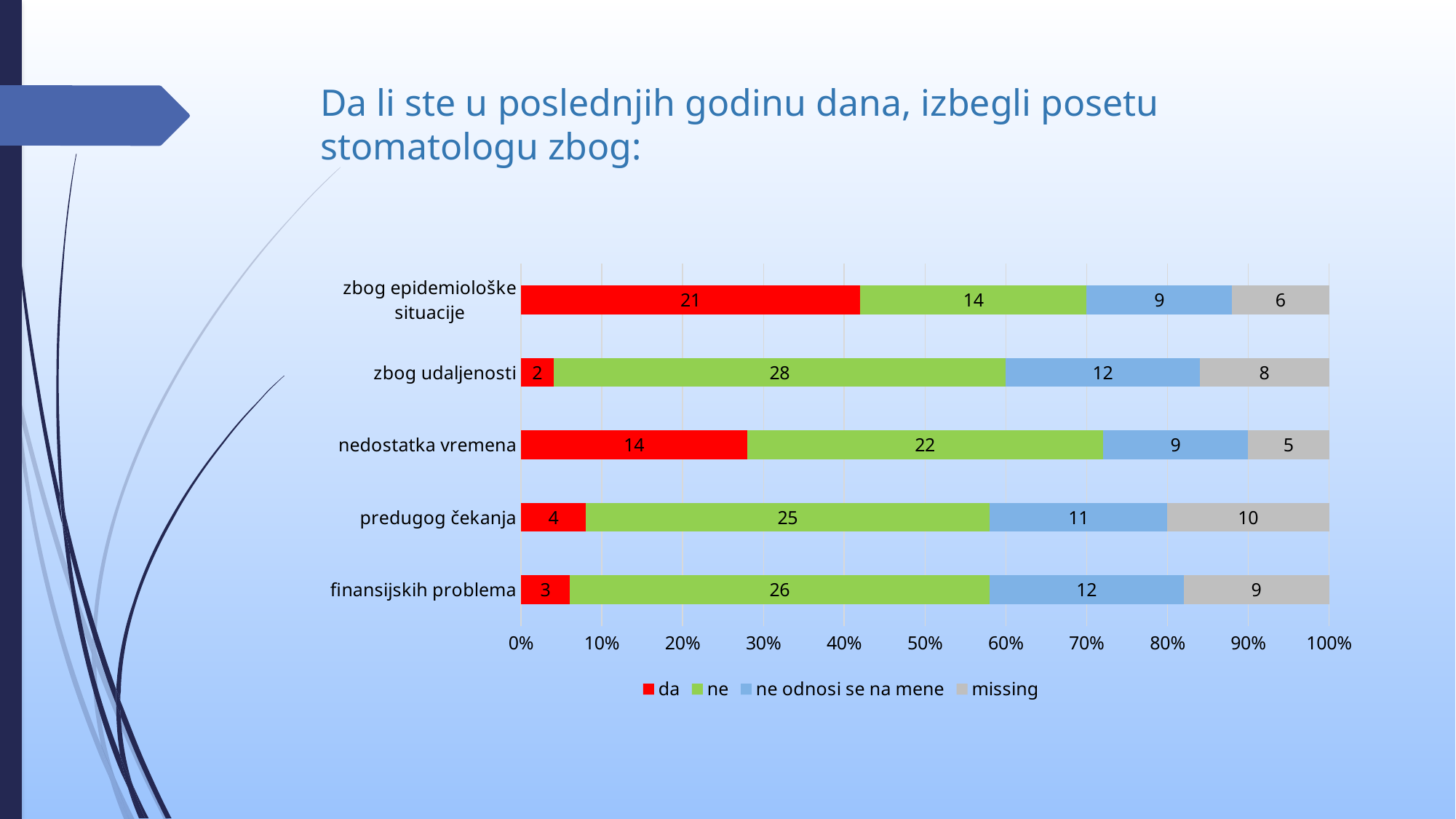
Which category has the lowest value in the "da" series? zbog udaljenosti What is the difference between the "ne" values for "zbog udaljenosti" and "nedostatka vremena"? 6 What kind of chart is shown on the slide? Stacked bar chart How many series does the legend list? 4 How many categories are shown on the chart? 5 What is the value of the "da" series for "zbog epidemiološke situacije"? 21 Which category has the highest value in the "da" series? zbog epidemiološke situacije Which is larger: the "da" value for "nedostatka vremena" or the "da" value for "predugog čekanja"? nedostatka vremena What is the value of the "ne odnosi se na mene" series for "finansijskih problema"? 12 What is the value of the "missing" series for "predugog čekanja"? 10 What is the value of the "ne" series for "zbog udaljenosti"? 28 What is the total of all segments in the bar for "nedostatka vremena"? 50